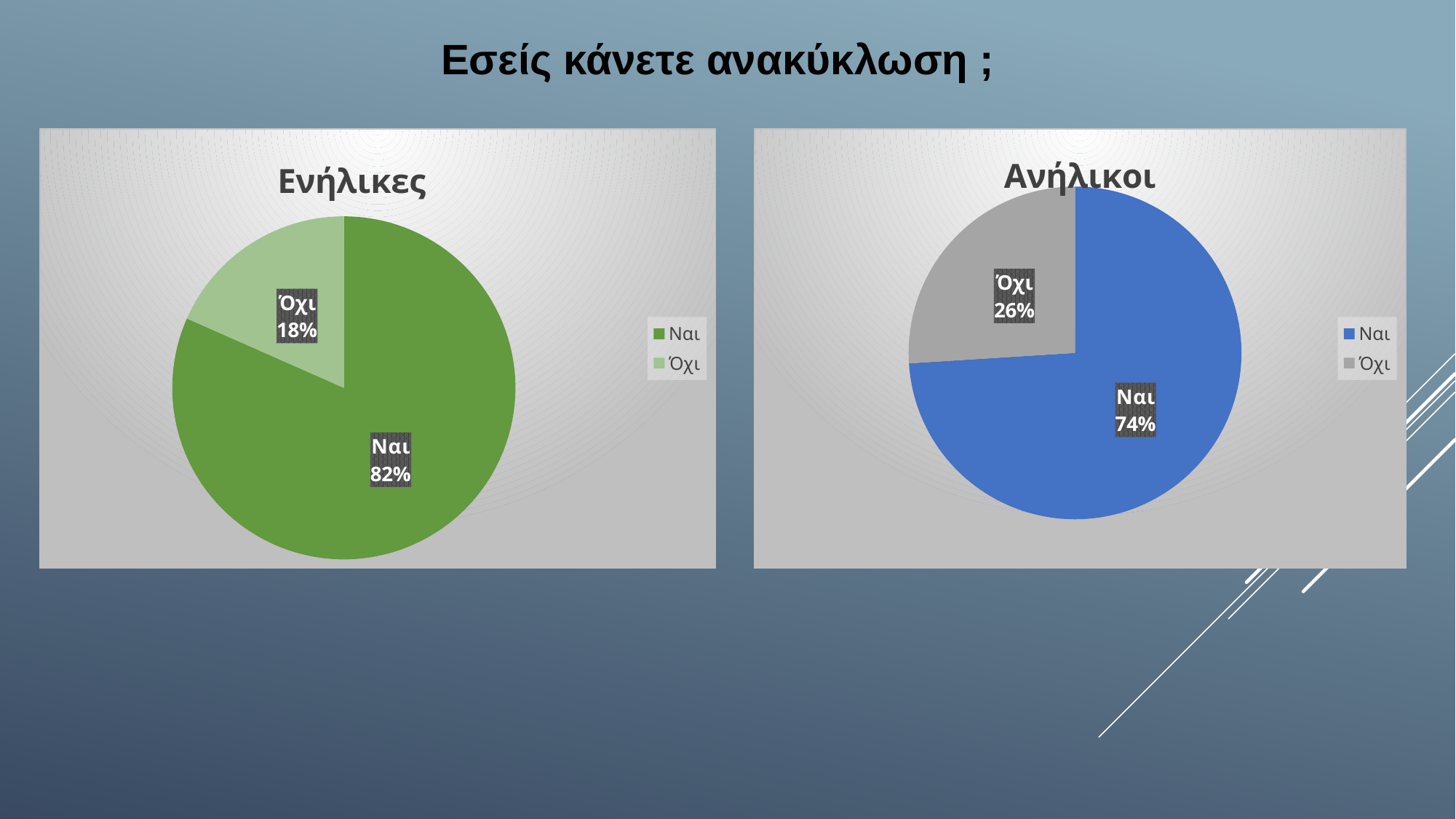
In the 'Ενήλικες' chart, what share of the pie is 'Όχι'? 18% In the 'Ενήλικες' chart, what share of the pie is 'Ναι'? 82% In the 'Ανήλικοι' chart, what share of the pie is 'Όχι'? 26% How many slices does the 'Ενήλικες' pie chart have? 2 In the 'Ενήλικες' chart, which slice is the largest? Ναι What kind of chart is the 'Ανήλικοι' chart? Pie chart In the 'Ενήλικες' chart, what is the difference between the 'Ναι' and 'Όχι' shares? 64% In the 'Ανήλικοι' chart, what colour is the 'Ναι' slice? Blue In the 'Ανήλικοι' chart, which slice is the smallest? Όχι In the 'Ανήλικοι' chart, what is the difference between the 'Ναι' and 'Όχι' shares? 48% Which chart has the larger 'Ναι' share, 'Ενήλικες' or 'Ανήλικοι'? Ενήλικες